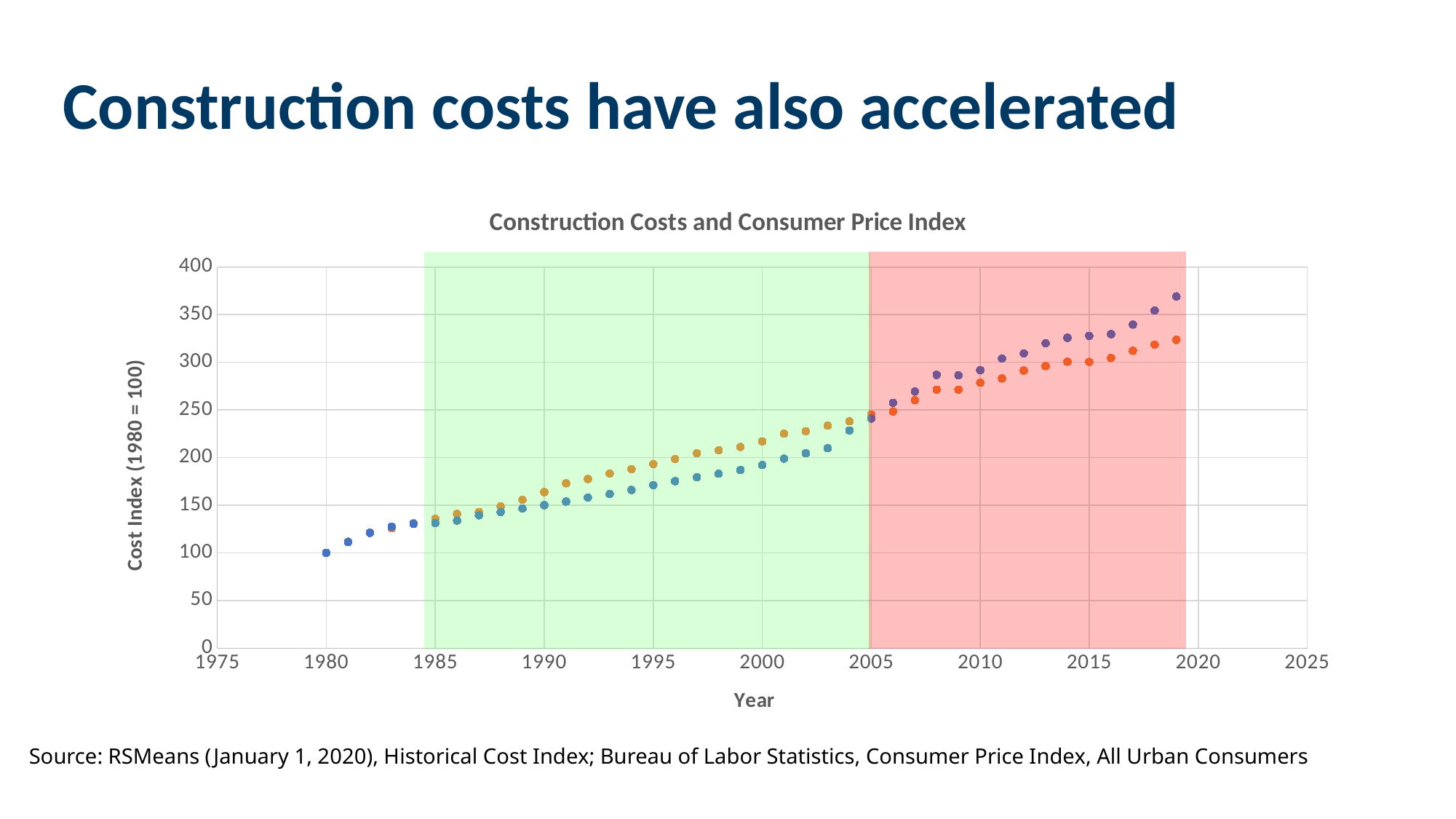
Is the highest value plotted for 2019 greater or less than 350? greater Is the lowest value plotted for 2019 greater or less than 350? less What is the label on the vertical axis of the chart? Cost Index (1980 = 100) What is the title of the chart? Construction Costs and Consumer Price Index Which year has the larger highest plotted value, 2010 or 2019? 2019 Do the plotted values generally rise or fall as the year increases? rise Is the highest value plotted for 2005 greater or less than 300? less What is the cost index value plotted for 1980? 100 Which year has the smaller lowest plotted value, 1985 or 1995? 1985 What kind of chart is shown on the slide? scatter chart